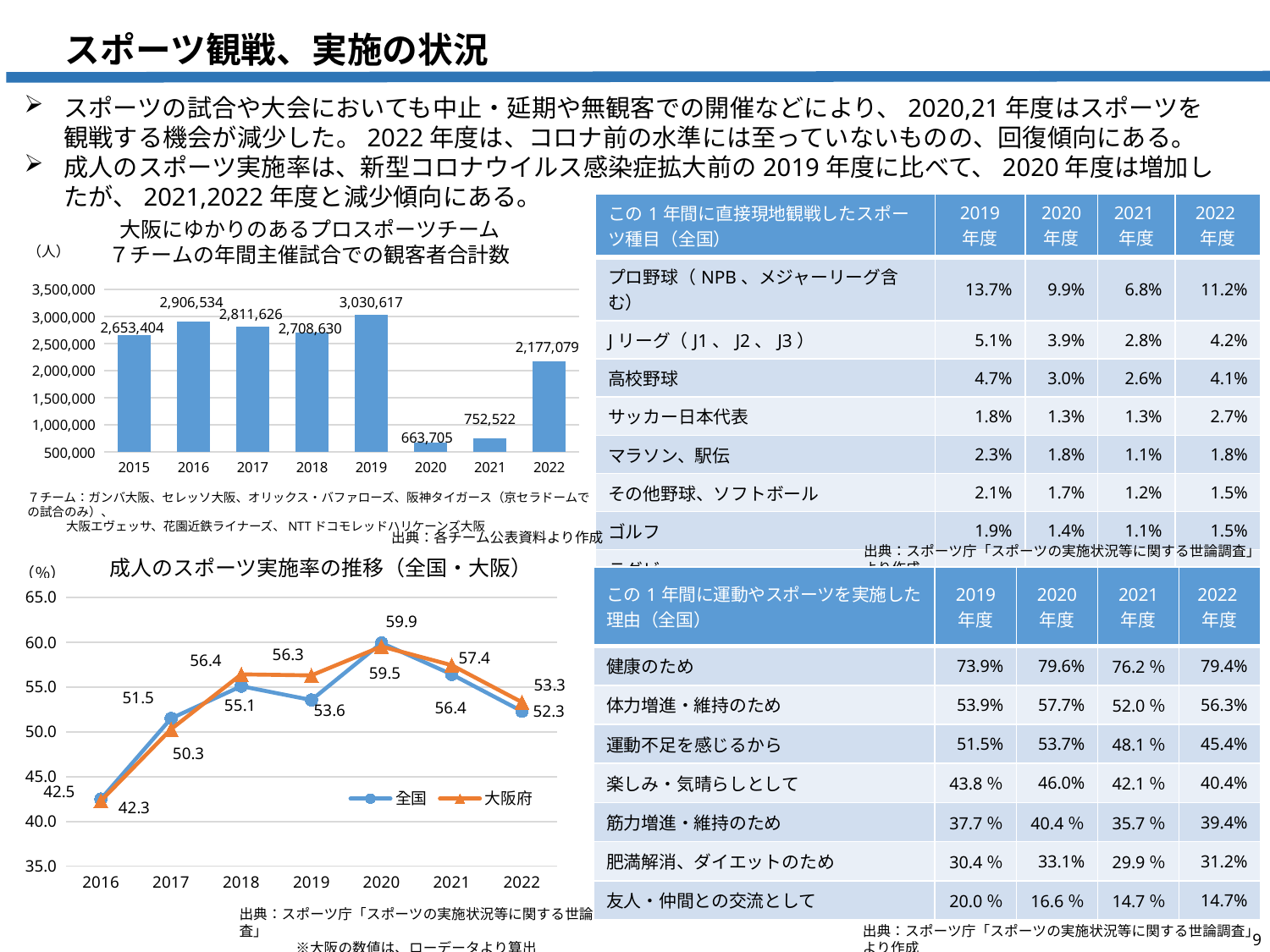
In the line chart 成人のスポーツ実施率の推移（全国・大阪）, what is the 大阪府 value for 2016? 42.3 In the bar chart of spectator totals for the 7 Osaka-related pro sports teams, what is the value for 2019? 3,030,617 In the bar chart of spectator totals for the 7 Osaka-related pro sports teams, which year has the lowest value? 2020 In the line chart 成人のスポーツ実施率の推移（全国・大阪）, which is larger in 2019, the 全国 value or the 大阪府 value? 大阪府 In the line chart 成人のスポーツ実施率の推移（全国・大阪）, what is the 全国 value for 2020? 59.9 In the bar chart of spectator totals for the 7 Osaka-related pro sports teams, what is the difference between the 2021 and 2020 values? 88,817 In the bar chart of spectator totals for the 7 Osaka-related pro sports teams, how many years are shown? 8 What kind of chart is the top-left chart showing spectator totals for the 7 Osaka-related pro sports teams? bar chart In the line chart 成人のスポーツ実施率の推移（全国・大阪）, what is the difference between the 大阪府 values for 2021 and 2022? 4.1 In the line chart 成人のスポーツ実施率の推移（全国・大阪）, how many series does the legend list? 2 In the bar chart of spectator totals for the 7 Osaka-related pro sports teams, which year has the highest value? 2019 In the bar chart of spectator totals for the 7 Osaka-related pro sports teams, is the value for 2022 greater or less than 2,000,000? greater